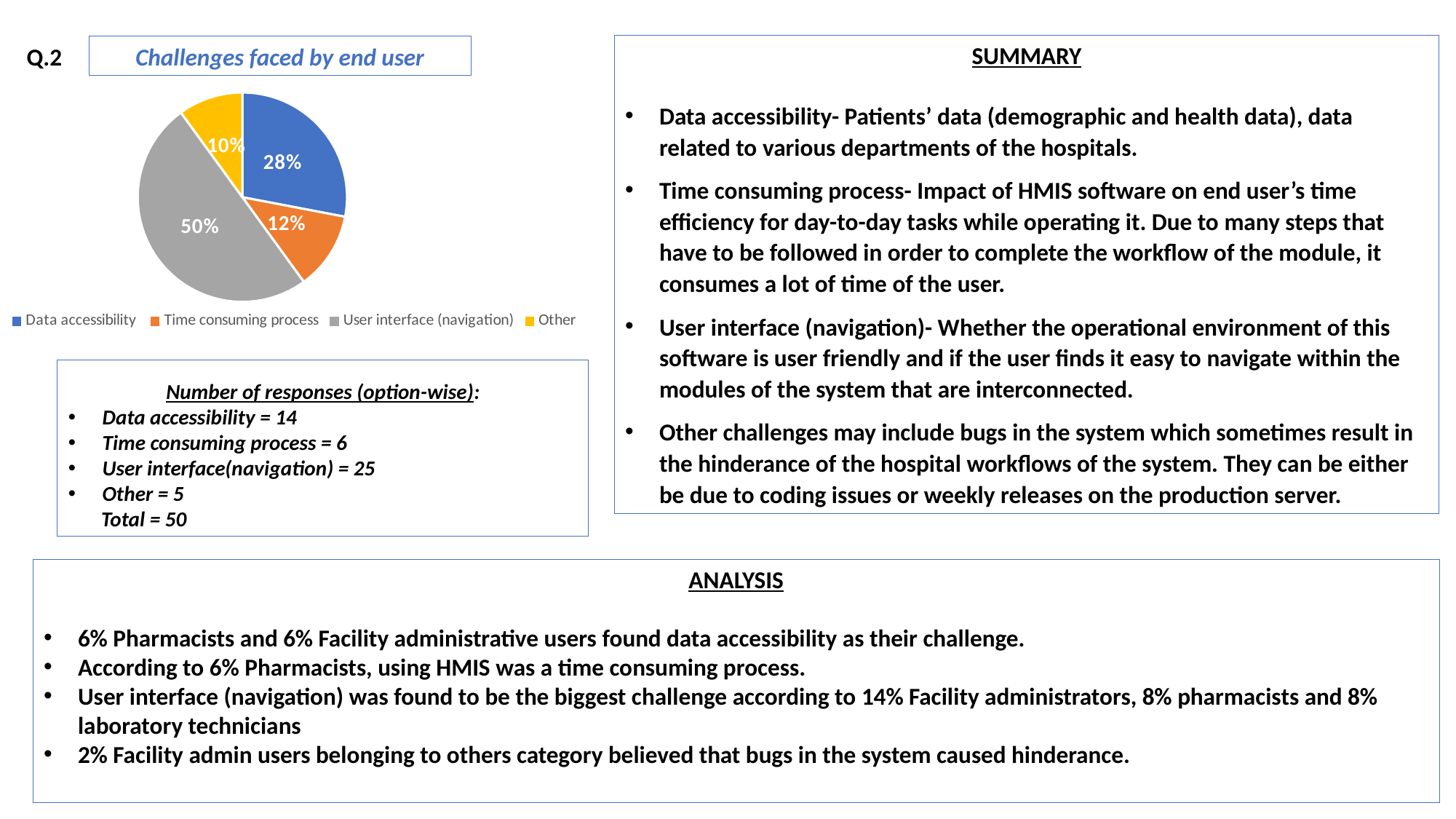
What percentage of the pie does User interface (navigation) represent? 50% What is the difference in percentage points between User interface (navigation) and Data accessibility? 22 What type of chart is shown on the slide? pie chart Which category has the smallest slice of the pie? Other What is the title of the chart? Challenges faced by end user What colour is the slice for User interface (navigation)? grey Which category has the largest slice of the pie? User interface (navigation) What percentage of the pie does Time consuming process represent? 12% What percentage of the pie does Data accessibility represent? 28% Which is larger, the slice for Data accessibility or the slice for Time consuming process? Data accessibility How many categories does the pie chart show? 4 What percentage of the pie does Other represent? 10%